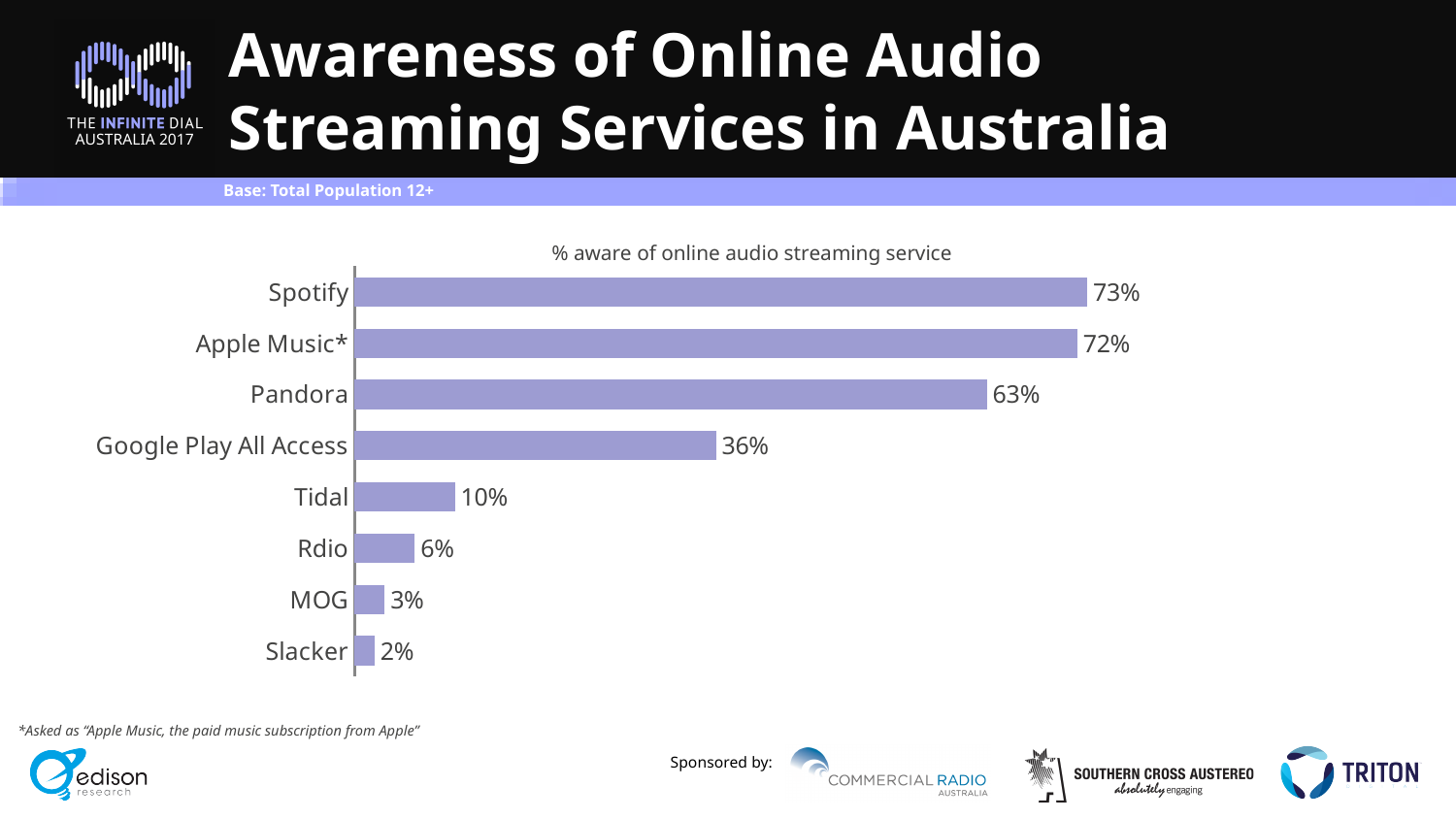
What is the title shown above the chart? % aware of online audio streaming service What is the difference in awareness between Spotify and Apple Music*? 1% Which has higher awareness, Pandora or Tidal? Pandora What percentage of respondents are aware of Spotify? 73% Which streaming service has the lowest awareness in the chart? Slacker Which has higher awareness, Rdio or MOG? Rdio Which streaming service has the highest awareness in the chart? Spotify How many streaming services are shown in the chart? 8 What percentage is shown for Tidal? 10% What is the difference in awareness between Pandora and Google Play All Access? 27% What is the awareness value shown for Google Play All Access? 36% What type of chart is used on this slide? Bar chart